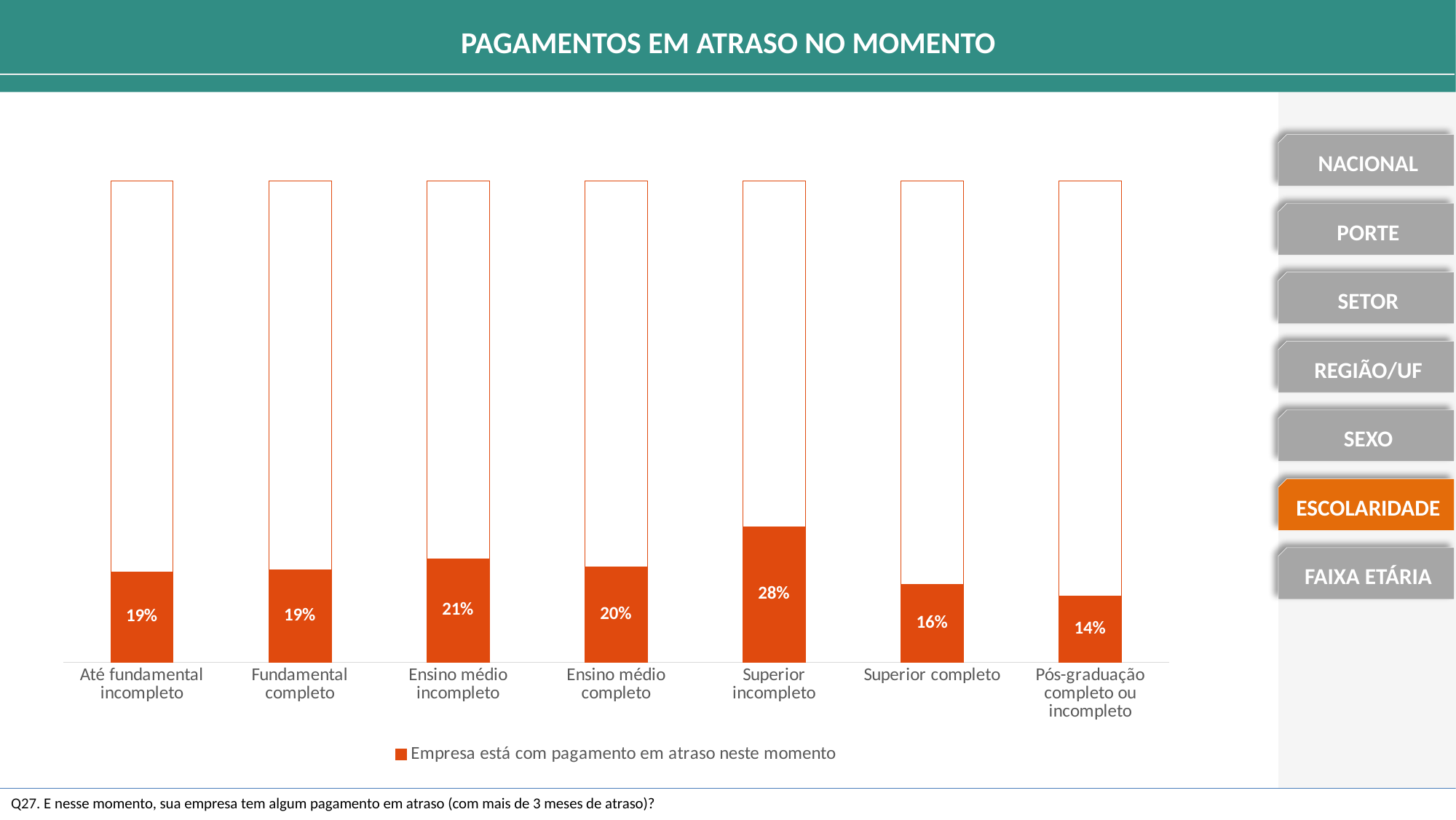
What kind of chart is shown? bar chart Which is larger, the value for Ensino médio completo or the value for Pós-graduação completo ou incompleto? Ensino médio completo Which category has the highest value? Superior incompleto How many categories are shown on the x axis? 7 What is the value for Superior incompleto? 28% What is the value for Superior completo? 16% How many series does the legend list? 1 What is the value for Pós-graduação completo ou incompleto? 14% What is the difference between the values for Superior incompleto and Superior completo? 12% What is the title of the chart? PAGAMENTOS EM ATRASO NO MOMENTO What is the value for Ensino médio incompleto? 21% Which category has the lowest value? Pós-graduação completo ou incompleto